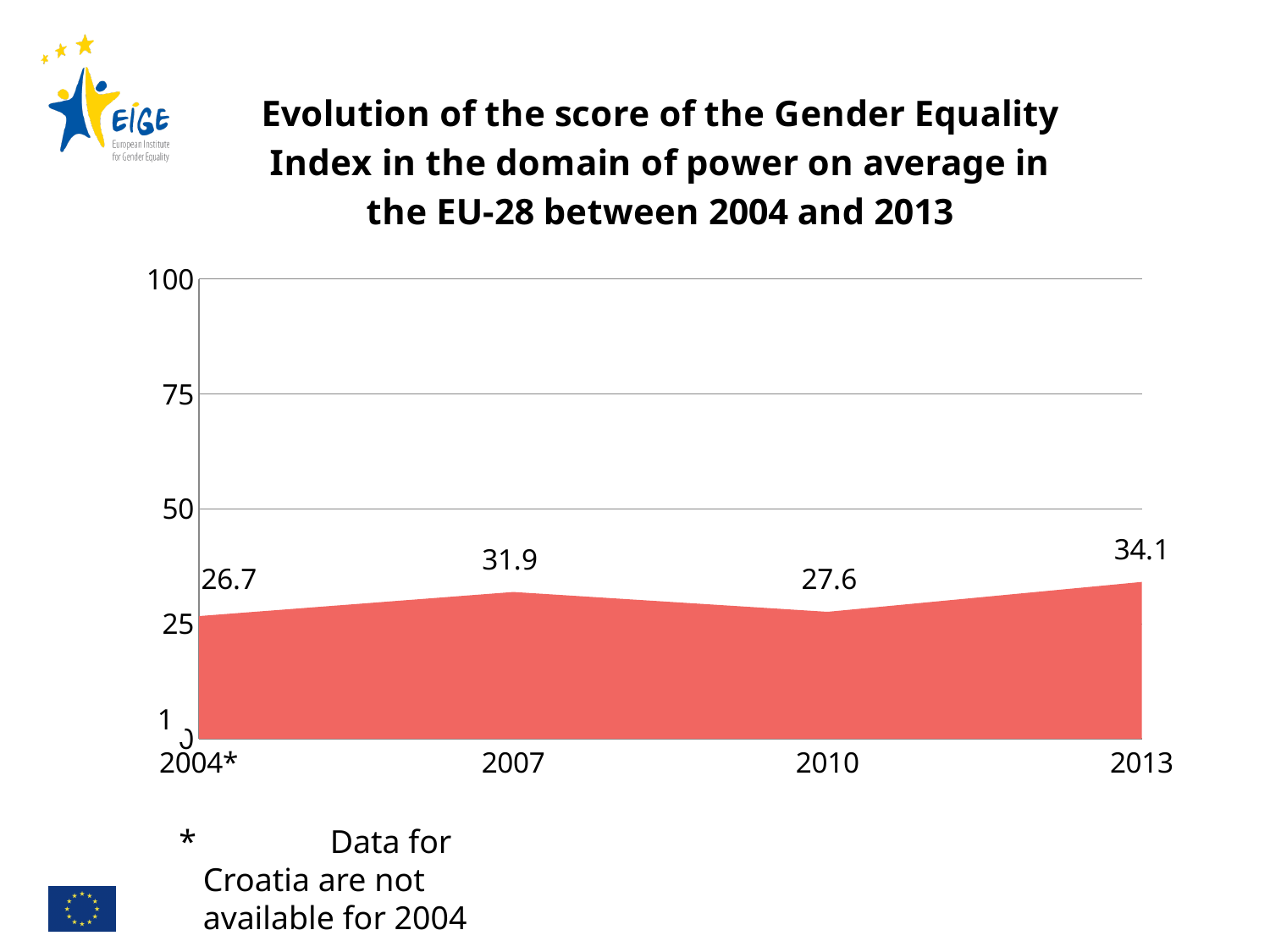
Which year has the highest score? 2013 Is the score for 2013 greater or less than 50? less How many years are plotted on the chart? 4 What is the difference between the scores for 2013 and 2004*? 7.4 What is the score for 2007? 31.9 Which is larger, the score for 2007 or the score for 2010? 2007 What is the score for 2004*? 26.7 Which year has the lowest score? 2004* What kind of chart is shown on the slide? area chart What is the score for 2013? 34.1 What is the difference between the scores for 2007 and 2010? 4.3 What is the score for 2010? 27.6